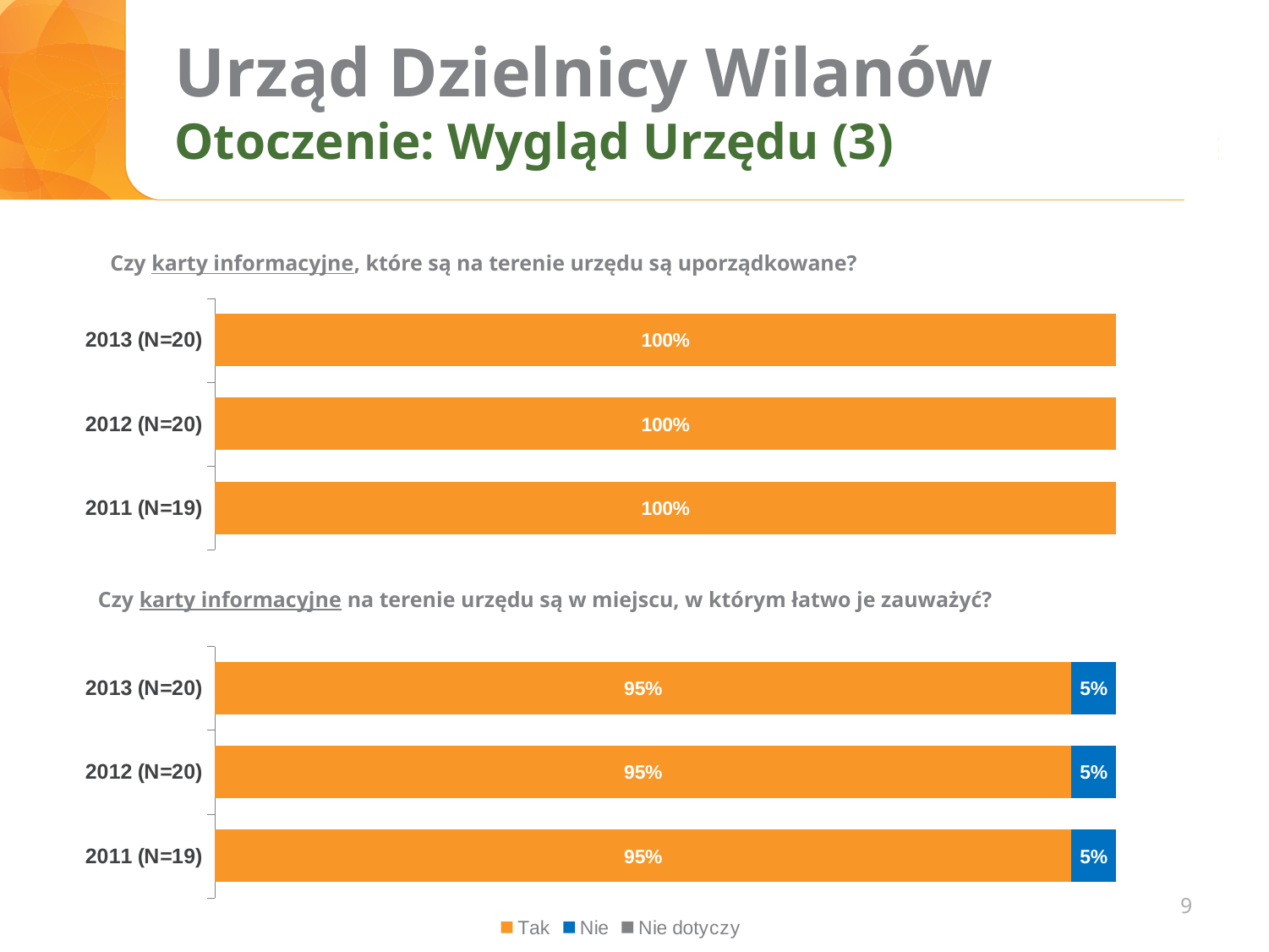
What are the three legend entries shown at the bottom of the slide? Tak, Nie, Nie dotyczy In the top chart ("Czy karty informacyjne, które są na terenie urzędu są uporządkowane?"), what is the value shown for 2013 (N=20)? 100% In the bottom chart ("Czy karty informacyjne na terenie urzędu są w miejscu, w którym łatwo je zauważyć?"), which is larger for 2013 (N=20): Tak or Nie? Tak In the bottom chart ("Czy karty informacyjne na terenie urzędu są w miejscu, w którym łatwo je zauważyć?"), what is the Nie value for 2013 (N=20)? 5% In the bottom chart ("Czy karty informacyjne na terenie urzędu są w miejscu, w którym łatwo je zauważyć?"), what is the difference between the Tak and Nie values for 2011 (N=19)? 90% How many series does the legend at the bottom of the slide list? 3 In the bottom chart ("Czy karty informacyjne na terenie urzędu są w miejscu, w którym łatwo je zauważyć?"), what is the total of the stacked bar for 2012 (N=20)? 100% In the bottom chart ("Czy karty informacyjne na terenie urzędu są w miejscu, w którym łatwo je zauważyć?"), what is the Tak value for 2012 (N=20)? 95% How many year categories are shown in the top chart ("Czy karty informacyjne, które są na terenie urzędu są uporządkowane?")? 3 In the top chart ("Czy karty informacyjne, które są na terenie urzędu są uporządkowane?"), what is the value shown for 2011 (N=19)? 100% What type of chart is the bottom chart ("Czy karty informacyjne na terenie urzędu są w miejscu, w którym łatwo je zauważyć?")? Bar chart In the bottom chart ("Czy karty informacyjne na terenie urzędu są w miejscu, w którym łatwo je zauważyć?"), does the Tak value rise, fall, or stay the same from 2011 to 2013? Stays the same